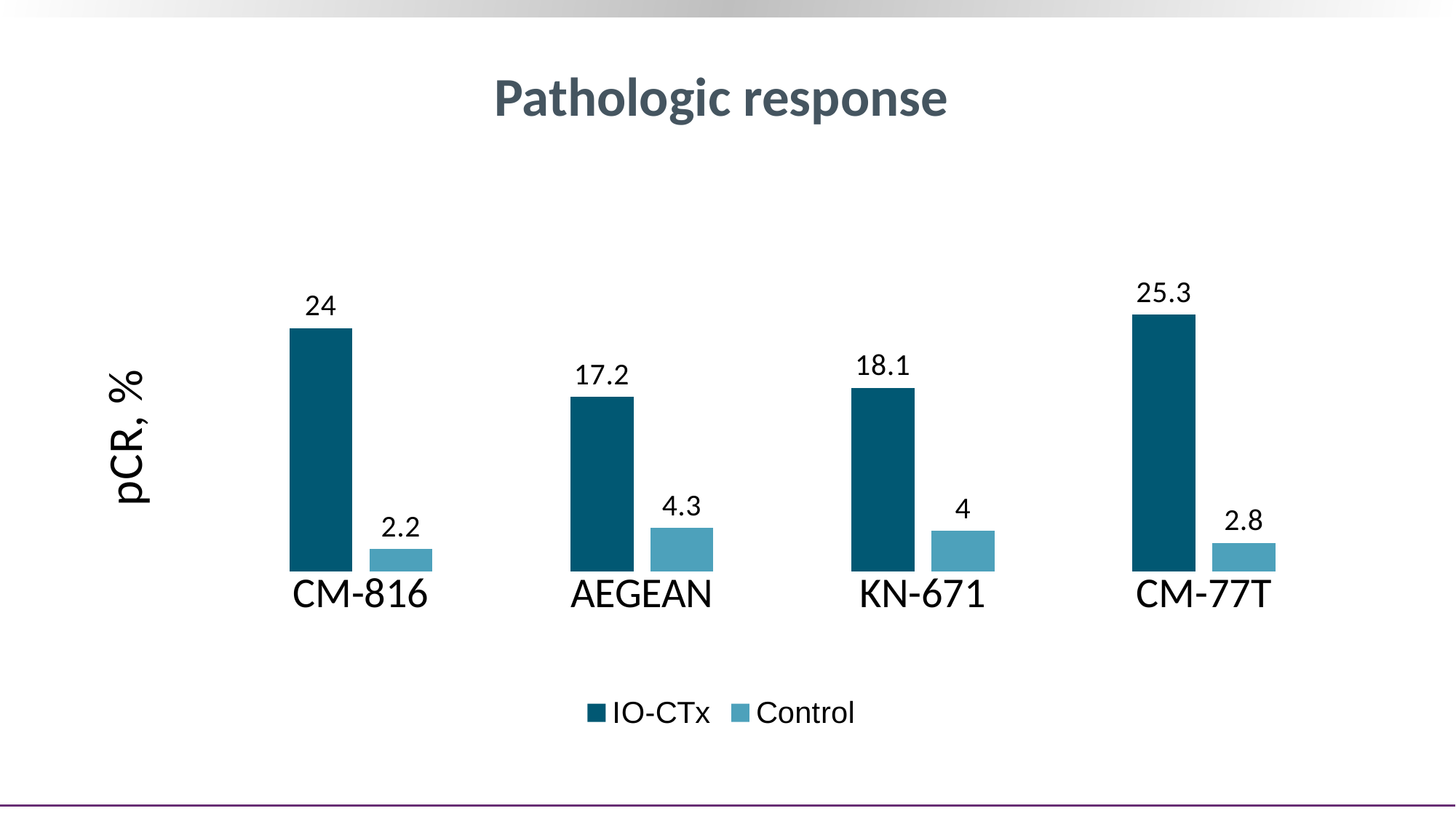
What is the IO-CTx pCR value for KN-671? 18.1 What is the IO-CTx pCR value for CM-816? 24 How many series does the legend list? 2 What kind of chart is shown? Bar chart What is the title of the chart? Pathologic response What is the Control pCR value for CM-77T? 2.8 What is the difference between the IO-CTx and Control pCR values for CM-816? 21.8 Which is larger, the IO-CTx pCR value for AEGEAN or for KN-671? KN-671 What is the Control pCR value for AEGEAN? 4.3 How many trials are shown on the x axis? 4 Which trial has the highest IO-CTx pCR value? CM-77T Which trial has the lowest Control pCR value? CM-816